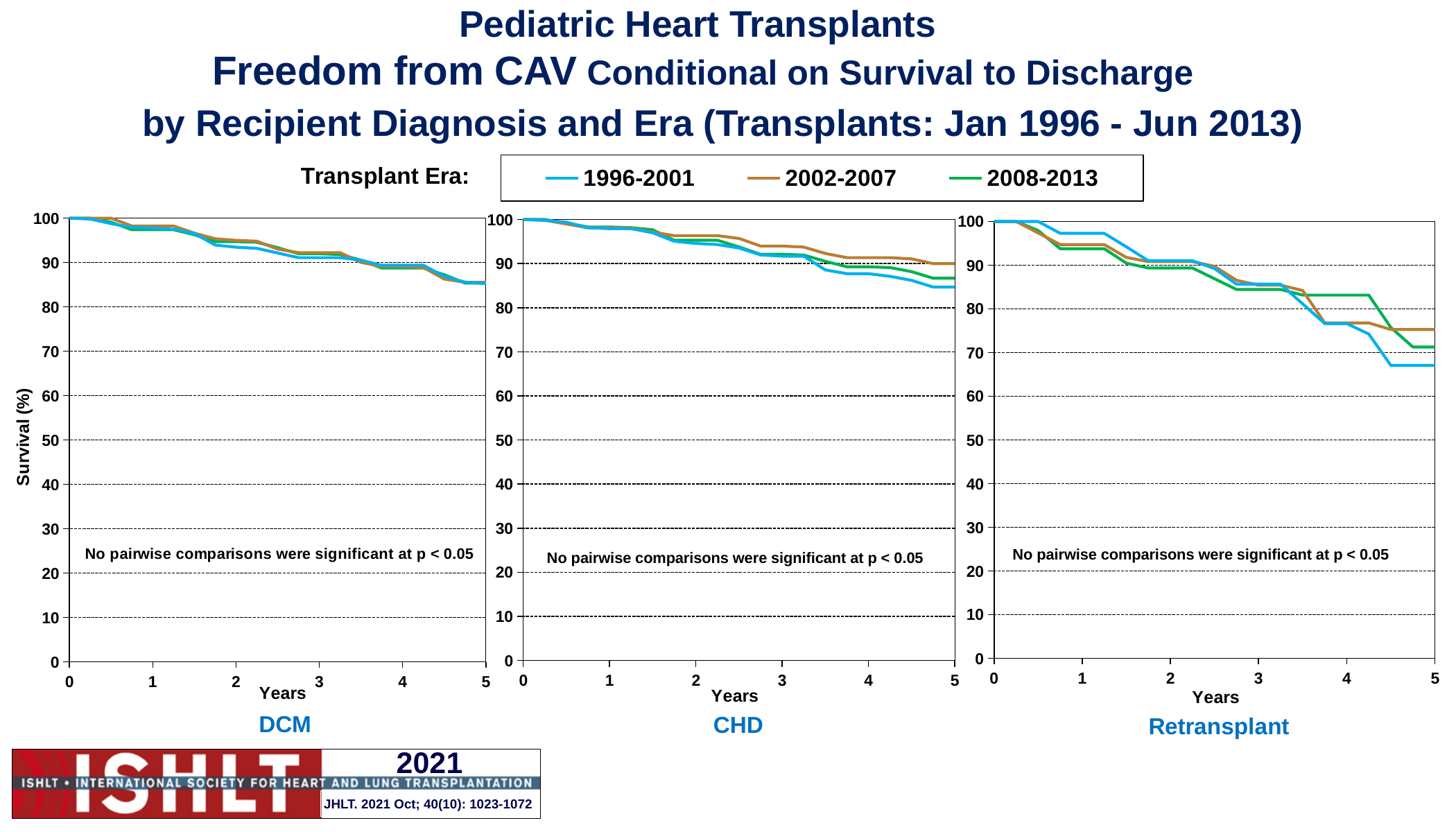
In the Retransplant chart, which series has the higher value at year 5: 1996-2001 or 2002-2007? 2002-2007 In the DCM chart, what is the survival value for the 1996-2001 series at year 0? 100 In the CHD chart, is the value for the 1996-2001 series at year 5 greater or less than 90? less In the Retransplant chart, do the values for the 1996-2001 series rise or fall as years increase? fall How many charts are shown on the slide? 3 How many series does the Transplant Era legend list? 3 In the Retransplant chart, is the value for the 2002-2007 series at year 5 greater or less than 70? greater In the Retransplant chart, is the value for the 1996-2001 series at year 5 greater or less than 70? less In the CHD chart, which series has the higher value at year 5: 1996-2001 or 2002-2007? 2002-2007 What is the label on the y axis of the DCM chart? Survival (%) What kind of chart is the DCM chart? line chart